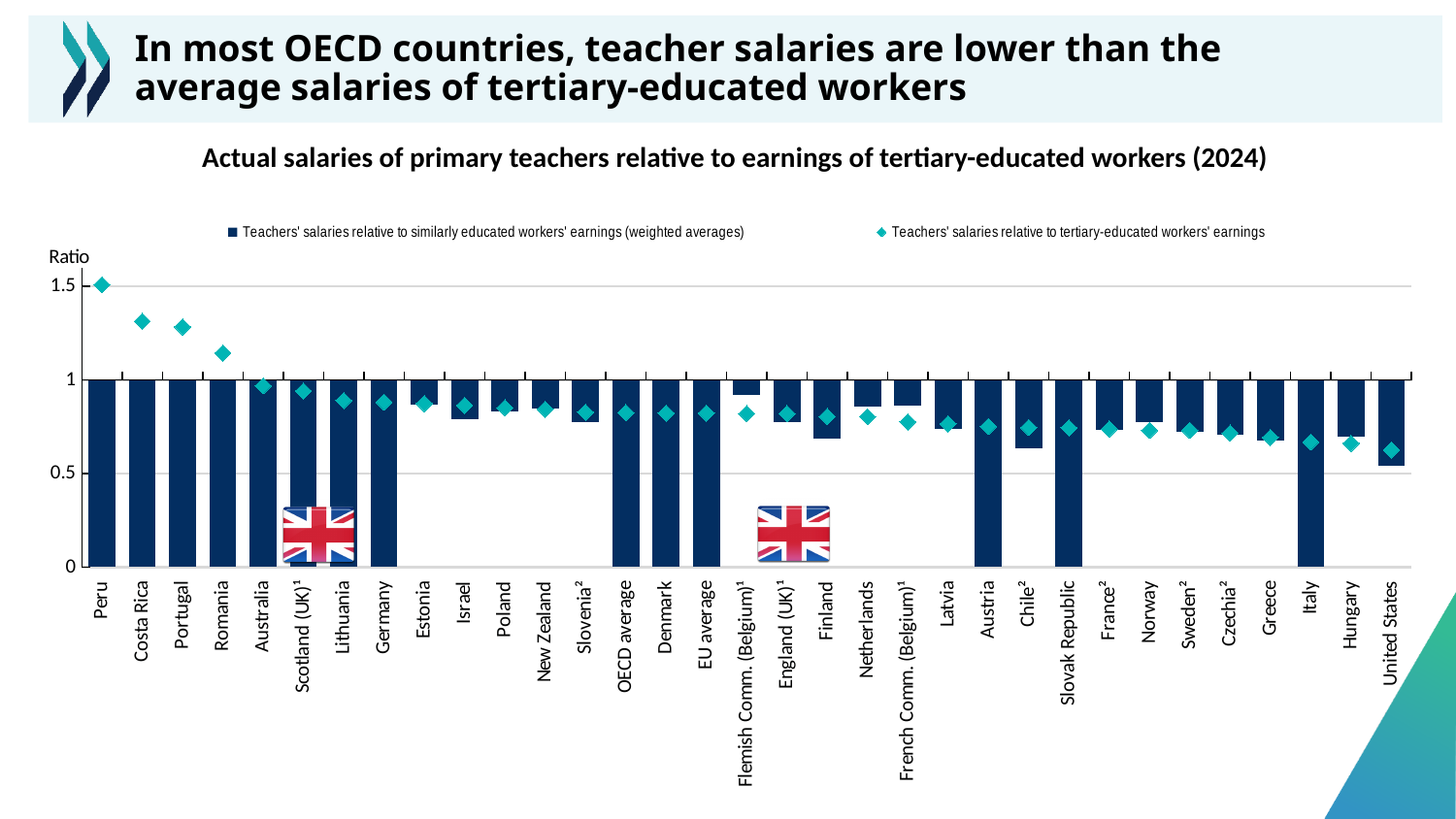
How many countries or entities are shown on the x axis? 33 Which country has the highest ratio of teachers' salaries relative to tertiary-educated workers' earnings? Peru What label is shown on the vertical axis? Ratio What is the title of the chart? Actual salaries of primary teachers relative to earnings of tertiary-educated workers (2024) Is the ratio for Costa Rica greater or less than 1? greater Which has a higher ratio, Peru or the United States? Peru How many series does the legend list? 2 What kind of chart is this? Bar chart with diamond markers Is the ratio for Italy greater or less than 1? less Do the ratios generally rise or fall moving from left to right along the x axis? fall Is the ratio for the United States greater or less than 1? less Which country has the lowest ratio of teachers' salaries relative to tertiary-educated workers' earnings? United States